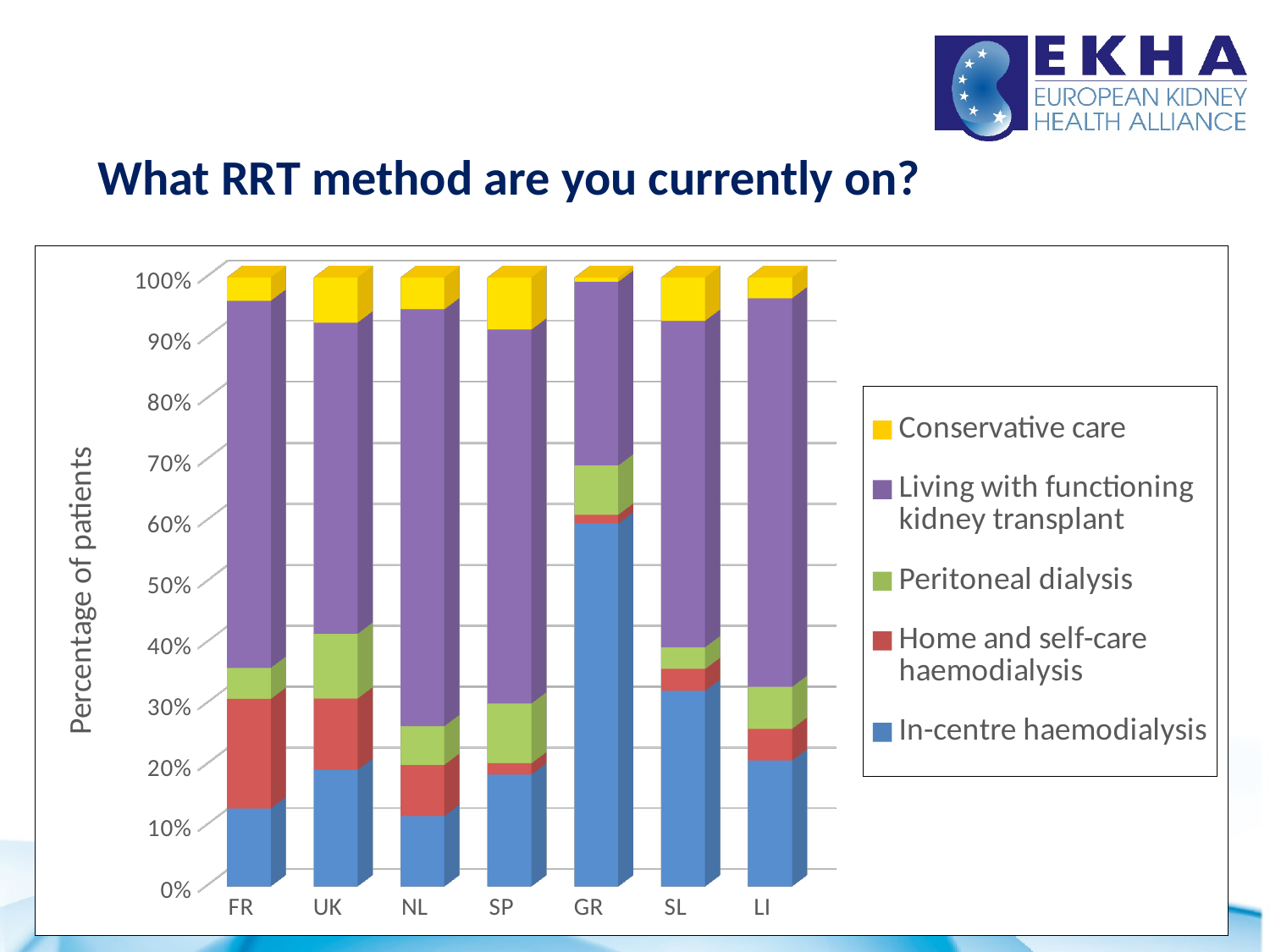
Is the In-centre haemodialysis value for NL greater or less than 20%? less Which is larger, the Home and self-care haemodialysis share for FR or for GR? FR Is the In-centre haemodialysis value for SL greater or less than 30%? greater How many series does the chart's legend list? 5 What is the label on the vertical axis of the chart? Percentage of patients Which country has the smallest share of Conservative care? GR What is the total of the stacked bar for FR? 100% How many countries are shown on the x axis of the chart? 7 What kind of chart is shown on the slide? Stacked bar chart Which country has the highest share of In-centre haemodialysis? GR Which country has the smallest share of Living with functioning kidney transplant? GR Is the In-centre haemodialysis value for GR greater or less than 50%? greater